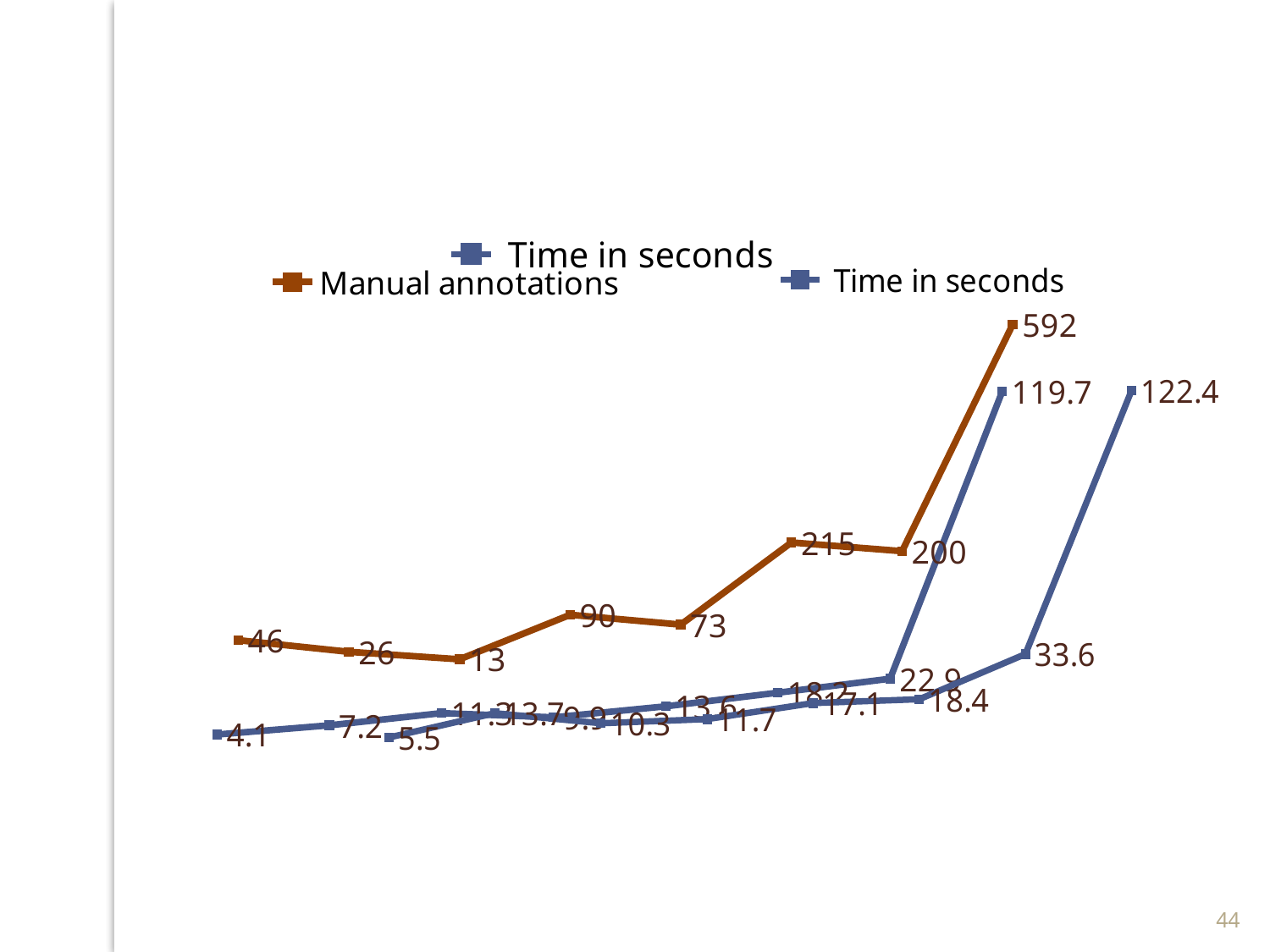
Overall, does the Manual annotations line rise or fall from left to right? rise What kind of chart is shown on the slide? line chart What is the lowest value labelled on any of the blue Time in seconds lines? 4.1 What is the difference between the last two labelled values on the Manual annotations line, 592 and 200? 392 What is the highest value labelled on the Manual annotations line? 592 How many series does the lower legend (with Manual annotations) list? 2 What is the lowest value labelled on the Manual annotations line? 13 What is the highest value labelled on any of the blue Time in seconds lines? 122.4 What is the first (leftmost) value labelled on the Manual annotations line? 46 How many data points are labelled on the Manual annotations line? 8 What is the difference between the Manual annotations values 215 and 200? 15 Which is larger: the final Manual annotations value or the final value of the blue line ending at 122.4? Manual annotations (592)